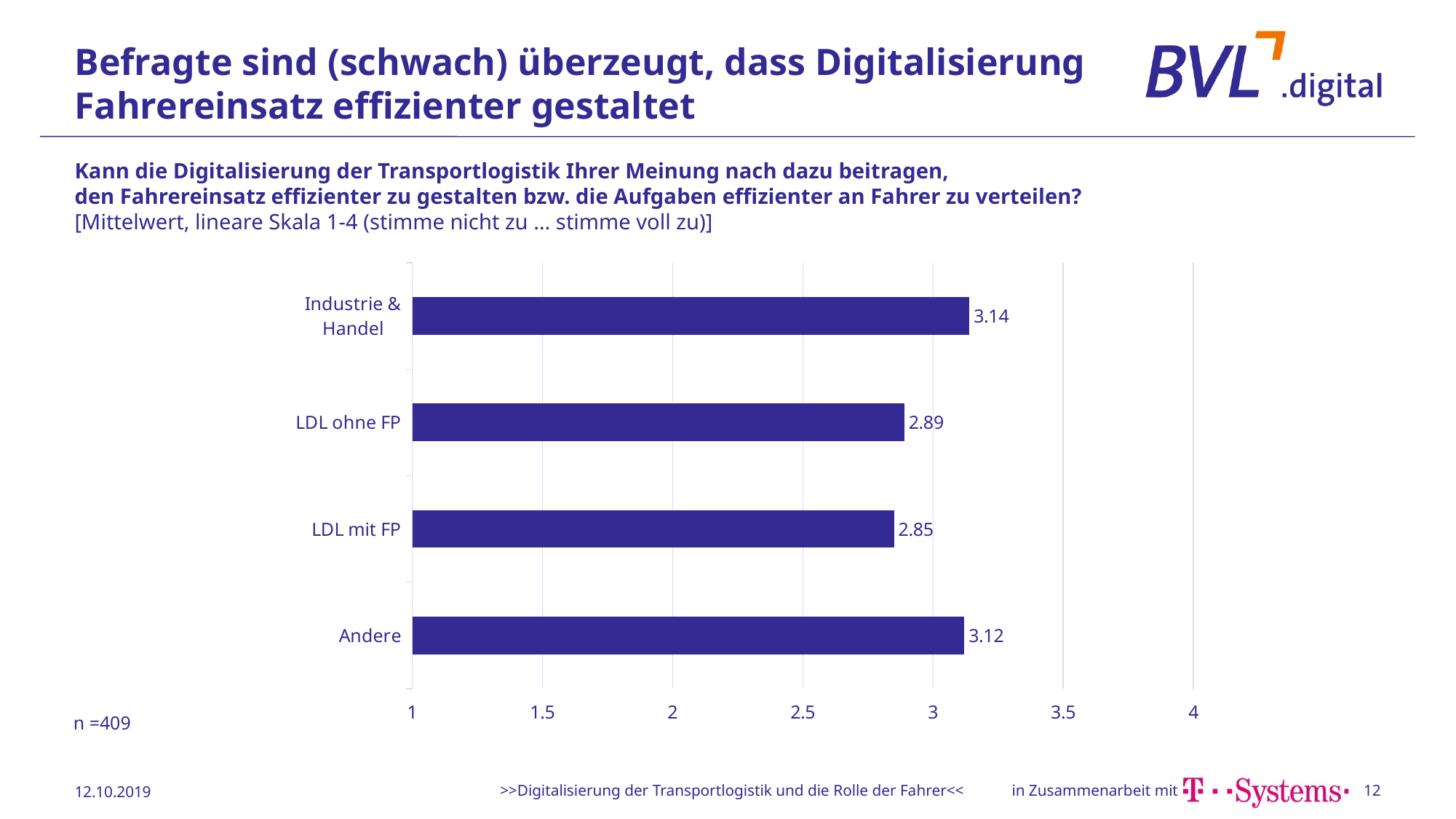
What is the difference between the values for LDL ohne FP and LDL mit FP? 0.04 What kind of chart is shown on the slide? Bar chart What is the difference between the values for Industrie & Handel and LDL mit FP? 0.29 What is the value for Andere? 3.12 Which category has the lowest value? LDL mit FP How many categories are shown in the chart? 4 What is the value for LDL mit FP? 2.85 What is the value for Industrie & Handel? 3.14 Which is larger, the value for Andere or the value for LDL ohne FP? Andere Is the value for LDL ohne FP greater or less than 3? less Which category has the highest value? Industrie & Handel What is the value for LDL ohne FP? 2.89